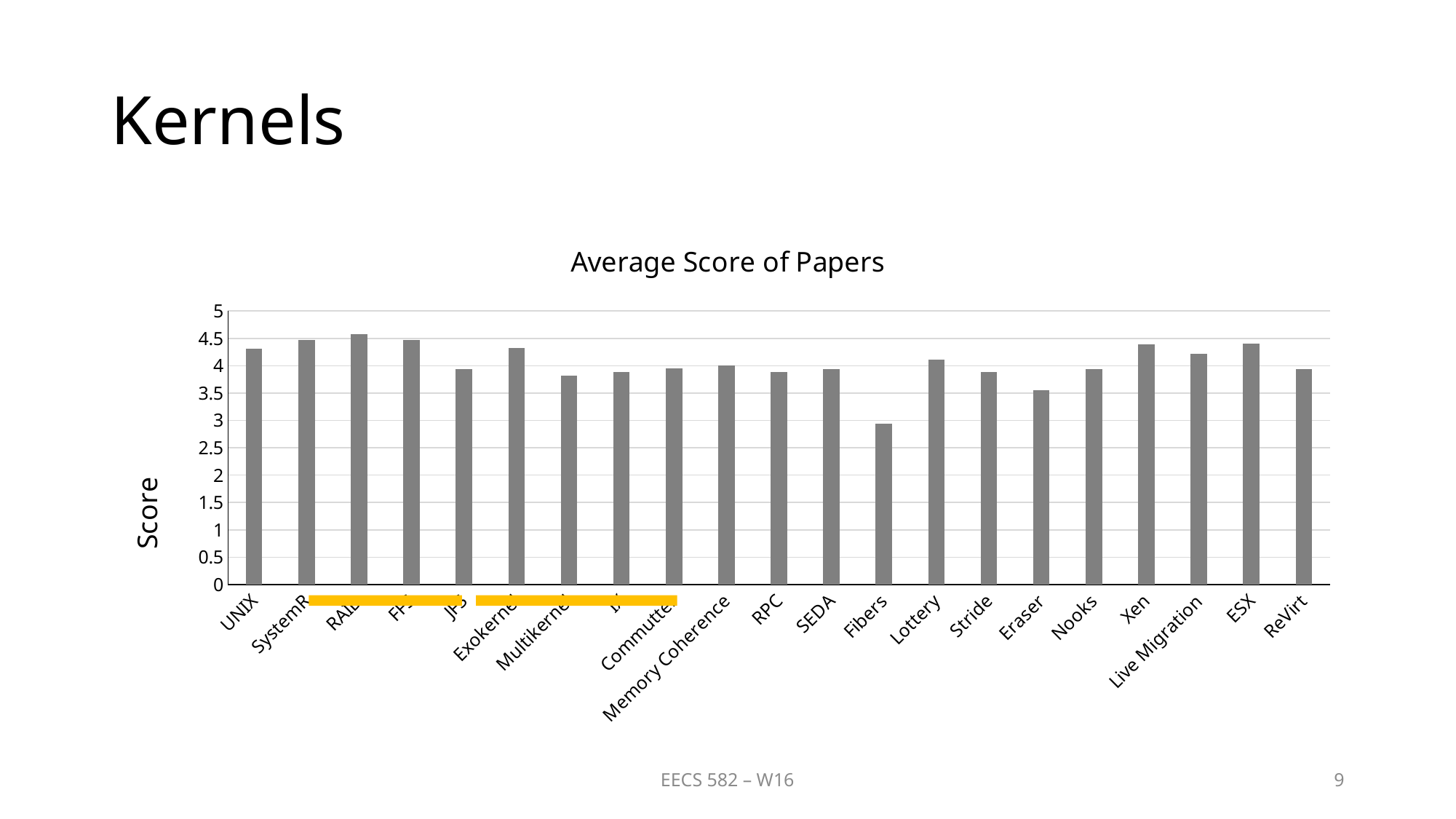
Which paper has the lowest average score? Fibers Is the value for ESX greater or less than 4? greater Which has a higher average score, Eraser or Fibers? Eraser Is the value for UNIX greater or less than 4? greater Is the value for Eraser greater or less than 4? less What is the title of the chart? Average Score of Papers What kind of chart is shown on the slide? bar chart Which has a higher average score, Xen or Eraser? Xen Which has a higher average score, SystemR or Fibers? SystemR What is the label on the vertical axis of the chart? Score